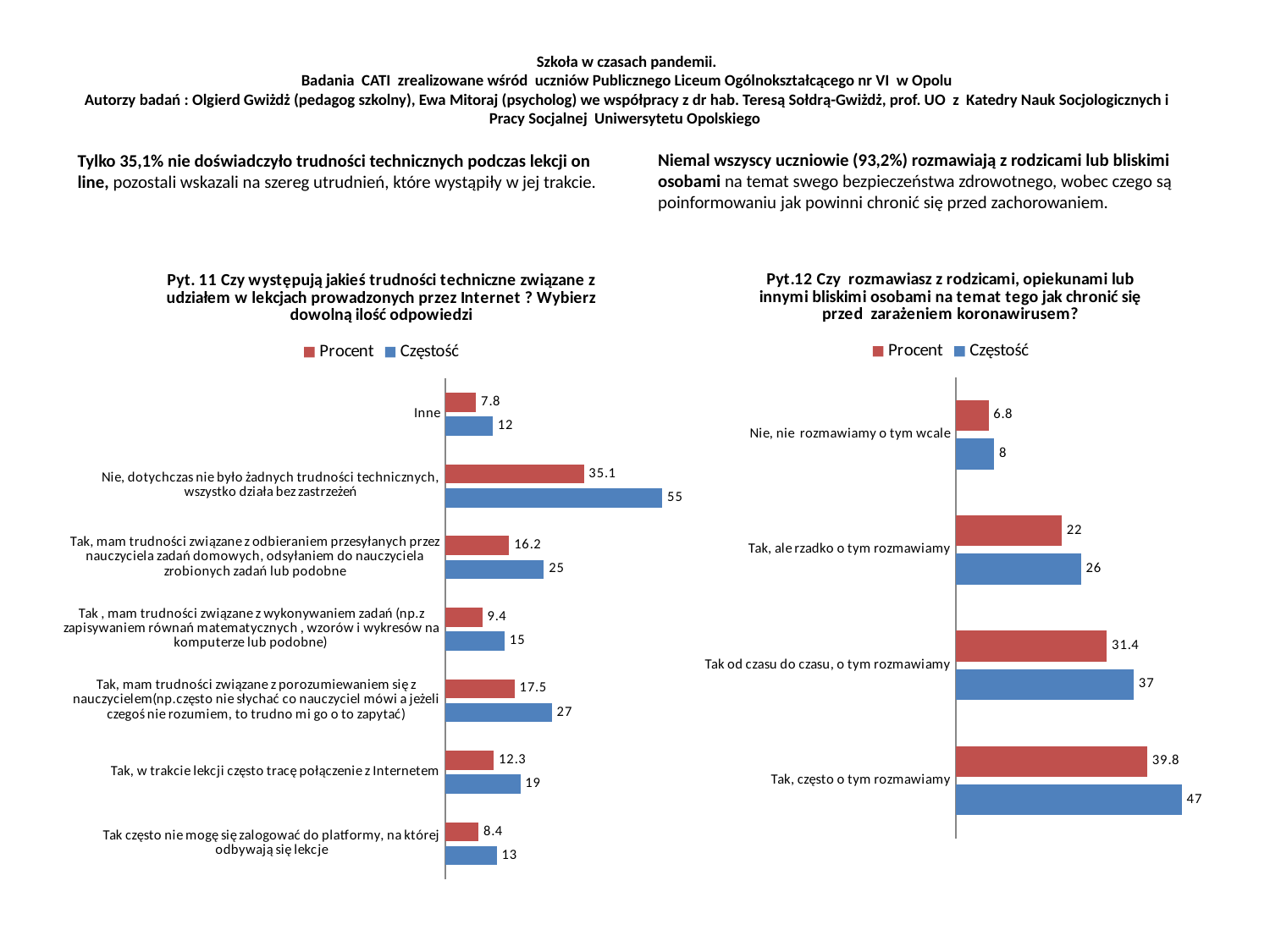
In the Pyt. 11 chart (left), which category has the lowest Częstość value? Inne How many series does the legend of the Pyt.12 chart (right) list? 2 In the Pyt.12 chart (right), what is the Częstość value for "Tak, ale rzadko o tym rozmawiamy"? 26 In the Pyt. 11 chart (left), how many categories are shown? 7 In the Pyt.12 chart (right), what is the difference between the Częstość values for "Tak, często o tym rozmawiamy" and "Tak od czasu do czasu, o tym rozmawiamy"? 10 In the Pyt. 11 chart (left), what is the difference between the Częstość values for "Tak, mam trudności związane z porozumiewaniem się z nauczycielem" and "Tak, w trakcie lekcji często tracę połączenie z Internetem"? 8 In the Pyt.12 chart (right), what is the Procent value for "Tak, często o tym rozmawiamy"? 39.8 In the Pyt. 11 chart (left), which category has the highest Procent value? Nie, dotychczas nie było żadnych trudności technicznych, wszystko działa bez zastrzeżeń In the Pyt. 11 chart (left), what is the Procent value for "Tak, w trakcie lekcji często tracę połączenie z Internetem"? 12.3 In the Pyt.12 chart (right), which category has the lowest Częstość value? Nie, nie rozmawiamy o tym wcale In the Pyt. 11 chart (left), what is the Częstość value for "Nie, dotychczas nie było żadnych trudności technicznych, wszystko działa bez zastrzeżeń"? 55 In the Pyt.12 chart (right), which is larger: the Częstość value for "Tak od czasu do czasu, o tym rozmawiamy" or for "Tak, ale rzadko o tym rozmawiamy"? Tak od czasu do czasu, o tym rozmawiamy